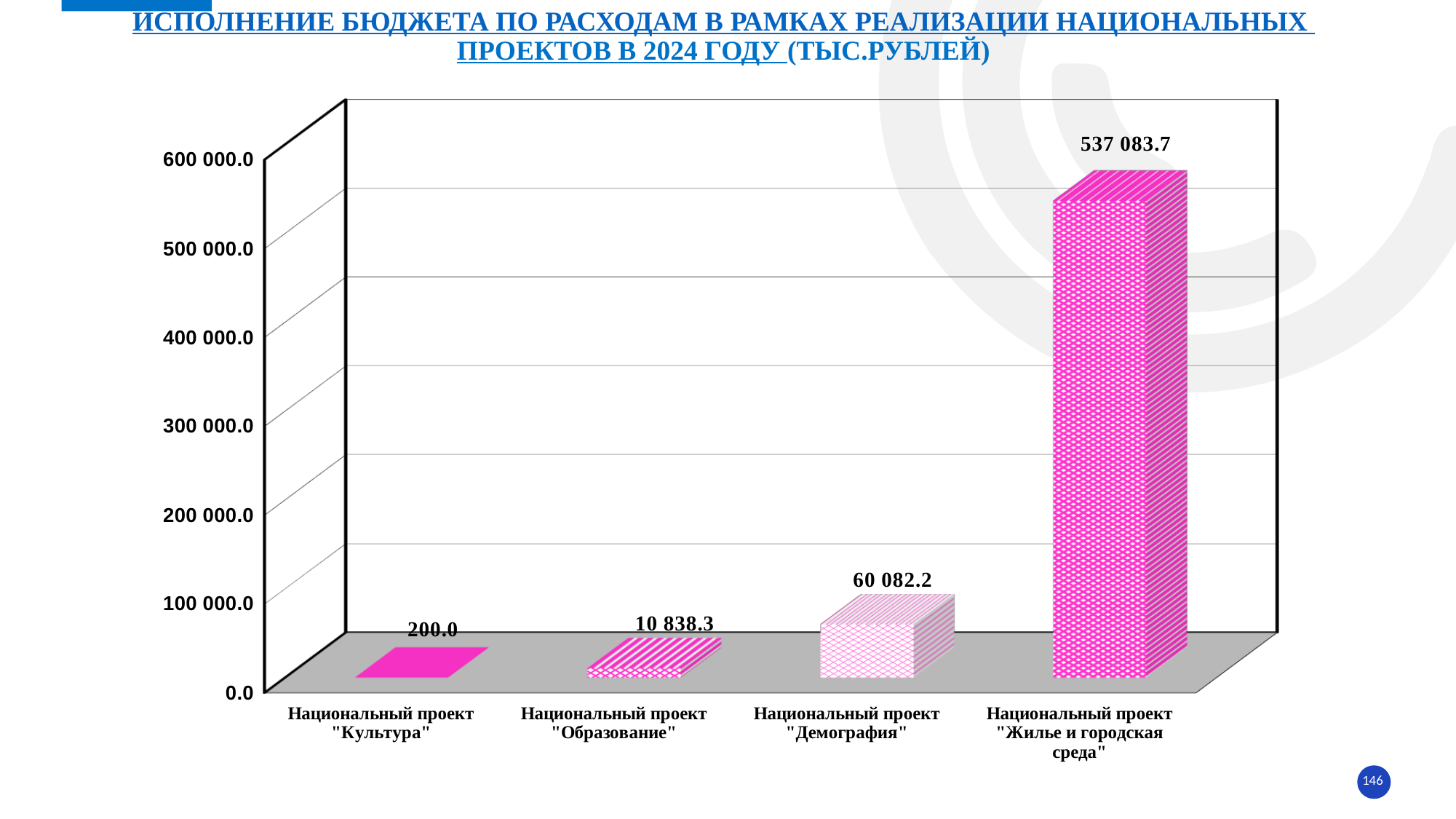
Is the value for "Жилье и городская среда" greater or less than 500 000.0? greater What is the value for the national project "Демография"? 60 082.2 What is the difference between the values for "Демография" and "Образование"? 49 243.9 Which national project has the highest value? Национальный проект "Жилье и городская среда" What is the value for the national project "Образование"? 10 838.3 Which national project has the lowest value? Национальный проект "Культура" What kind of chart is shown on the slide? Bar chart What is the difference between the values for "Жилье и городская среда" and "Демография"? 477 001.5 How many national projects are shown on the chart? 4 What is the value for the national project "Жилье и городская среда"? 537 083.7 What is the value for the national project "Культура"? 200.0 Which is larger, the value for "Образование" or the value for "Демография"? Демография